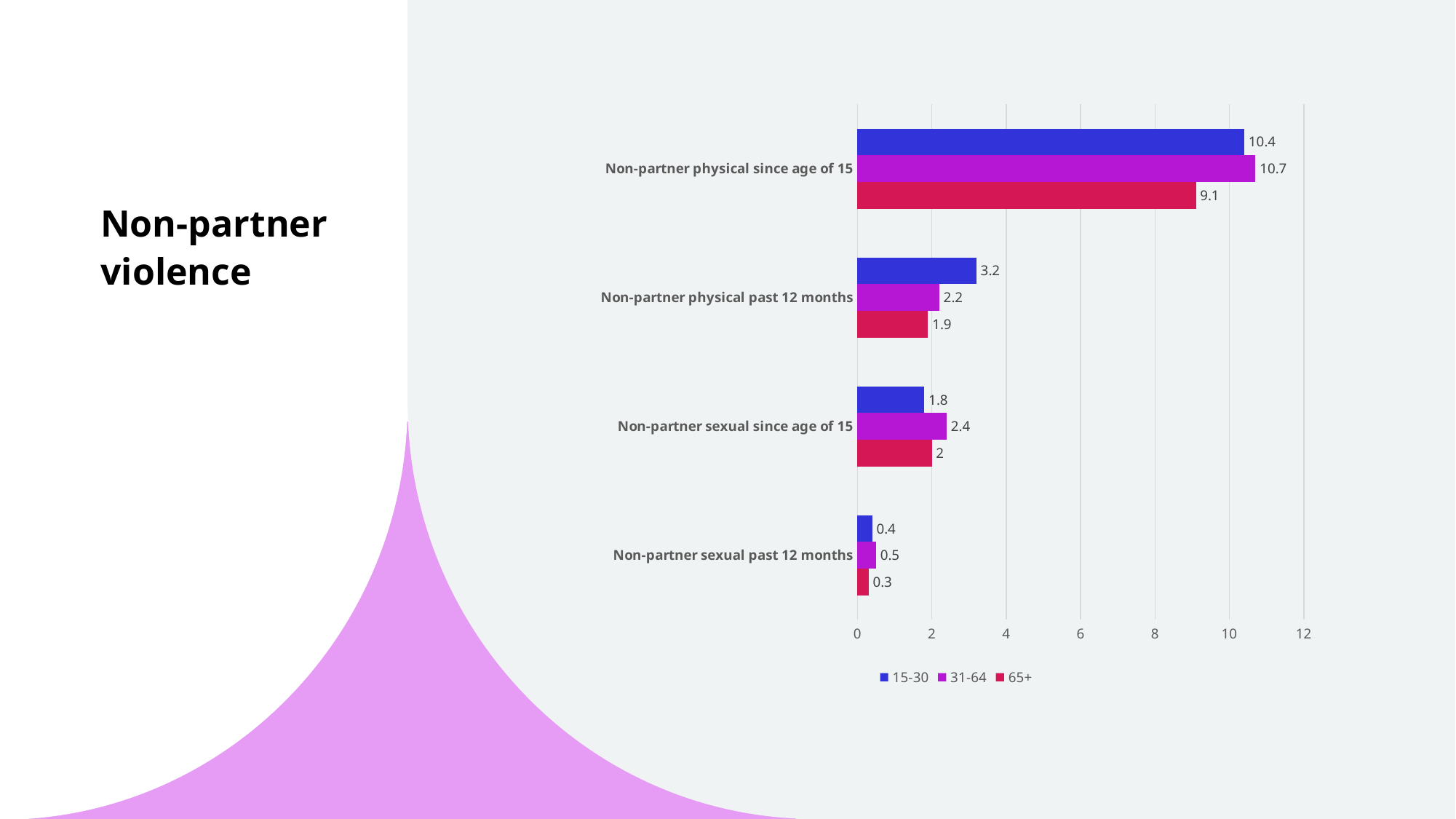
How many series does the legend list? 3 What is the value for the 31-64 age group for Non-partner sexual since age of 15? 2.4 What is the value for the 15-30 age group for Non-partner physical since age of 15? 10.4 What is the value for the 65+ age group for Non-partner sexual past 12 months? 0.3 What is the difference between the 31-64 and 65+ values for Non-partner physical since age of 15? 1.6 Is the value for the 15-30 age group for Non-partner physical since age of 15 greater or less than 8? greater Which age group has the lowest value for Non-partner physical past 12 months? 65+ How many categories are shown on the chart? 4 What kind of chart is shown on the slide? Bar chart Which is larger for Non-partner sexual since age of 15: the 15-30 value or the 65+ value? 65+ Which age group has the highest value for Non-partner physical since age of 15? 31-64 What is the value for the 65+ age group for Non-partner physical past 12 months? 1.9